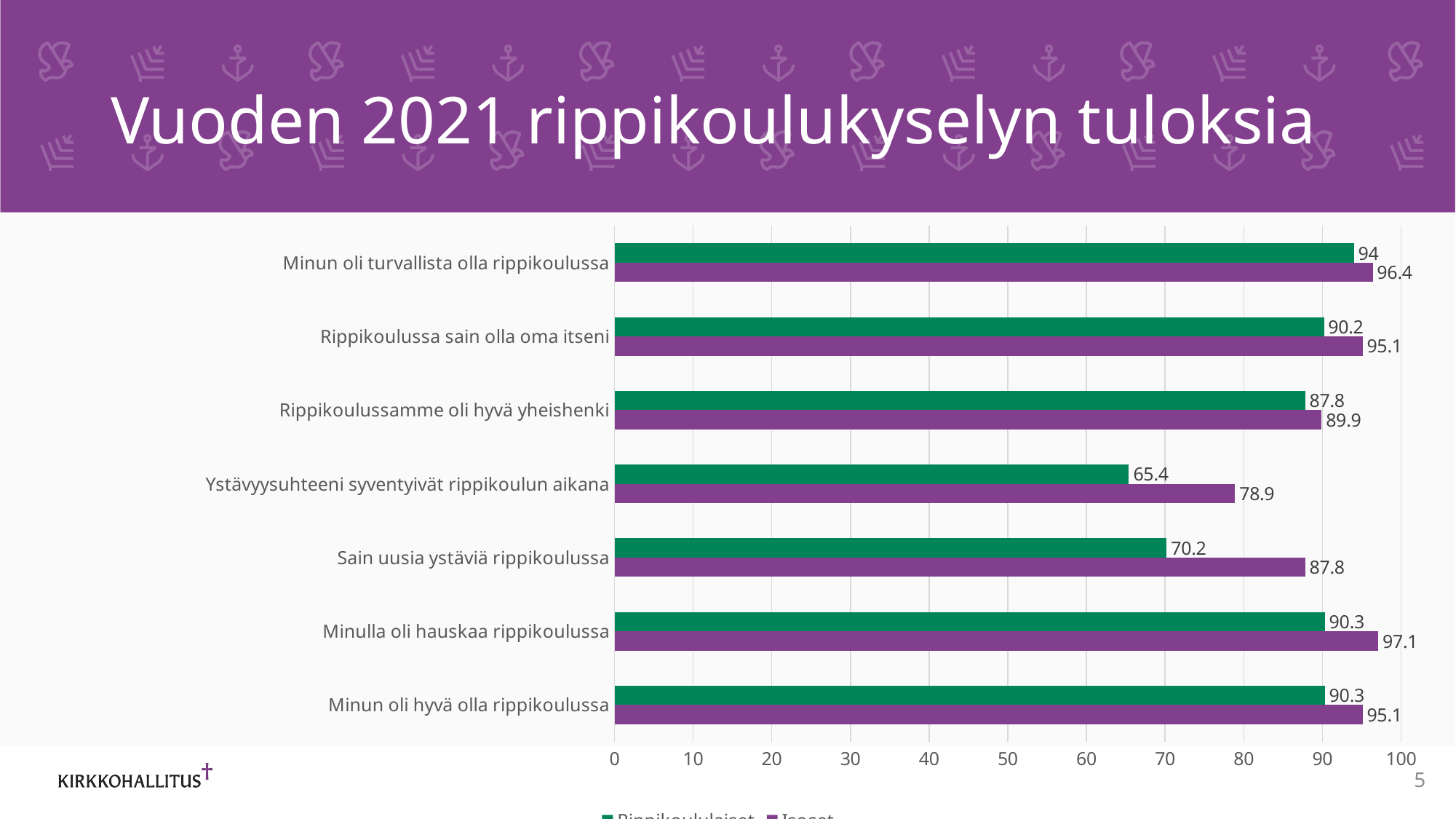
What is the value of the purple bar for "Minulla oli hauskaa rippikoulussa"? 97.1 How many categories are shown on the chart? 7 For "Rippikoulussamme oli hyvä yheishenki", which bar is larger, the green or the purple one? purple Which category has the highest value among the purple bars? Minulla oli hauskaa rippikoulussa What is the value of the purple bar for "Sain uusia ystäviä rippikoulussa"? 87.8 What type of chart is shown on the slide? bar chart How many series does the chart show? 2 What is the value of the green bar for "Minun oli turvallista olla rippikoulussa"? 94 Which category has the lowest value among the green bars? Ystävyyssuhteeni syventyivät rippikoulun aikana Is the green bar for "Sain uusia ystäviä rippikoulussa" greater or less than 80? less What is the value of the green bar for "Ystävyyssuhteeni syventyivät rippikoulun aikana"? 65.4 What is the difference between the purple and green bars for "Sain uusia ystäviä rippikoulussa"? 17.6